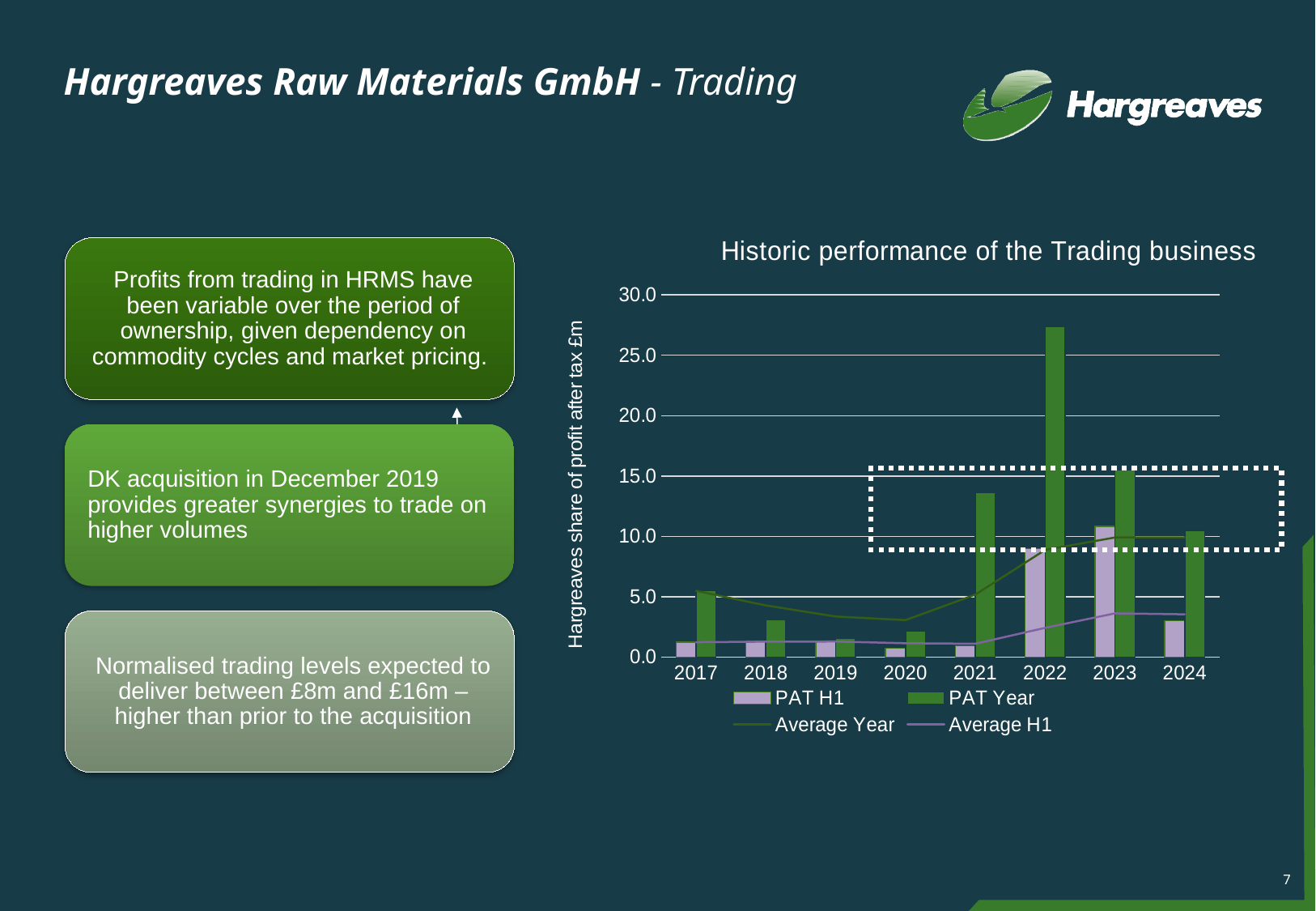
Is the PAT Year value for 2021 greater or less than 10.0? greater Is the PAT Year value for 2018 greater or less than 5.0? less Which year has the highest PAT H1 bar? 2023 What is the label on the vertical axis of the chart? Hargreaves share of profit after tax £m How many series does the chart legend list? 4 Do the PAT Year bars rise or fall from 2022 to 2024? fall Is the PAT Year value for 2022 greater or less than 25.0? greater Which year has the highest PAT Year bar? 2022 What type of chart is used in 'Historic performance of the Trading business'? Bar chart with line series How many years are shown on the x axis of the chart? 8 Which is larger, the PAT Year value for 2021 or for 2024? 2021